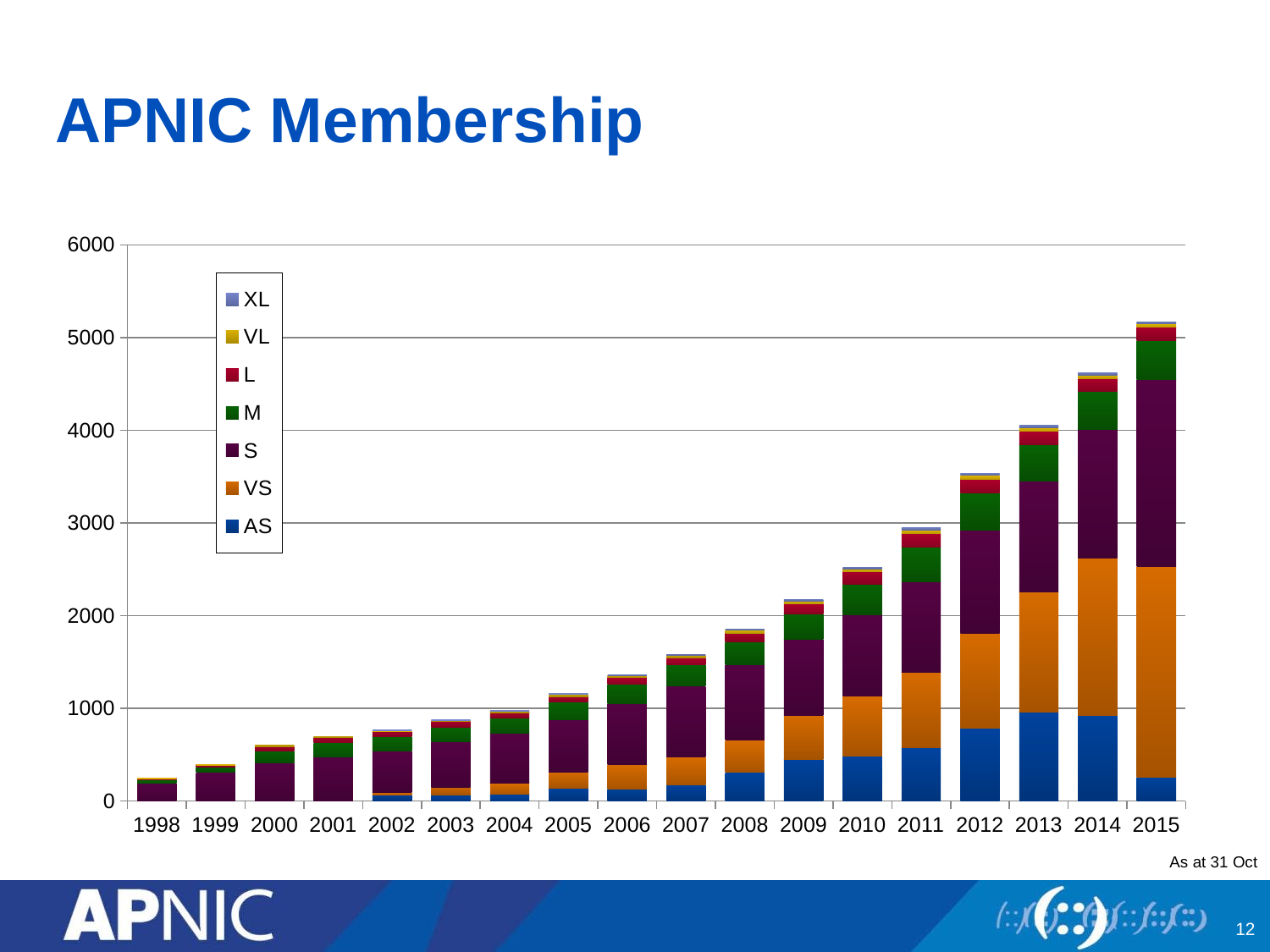
How many years are shown along the x axis of the chart? 18 What is the title of the chart? APNIC Membership How many series does the legend list? 7 Is the total membership for 2003 greater or less than 1000? less Is the total membership for 2008 greater or less than 2000? less Is the total membership for 2015 greater or less than 5000? greater Which year has the lowest total membership? 1998 Which year has the highest total membership? 2015 Do the total membership values rise or fall from 1998 to 2015? Rise What kind of chart is shown on the slide? Stacked bar chart Which year has a larger total membership, 2013 or 2014? 2014